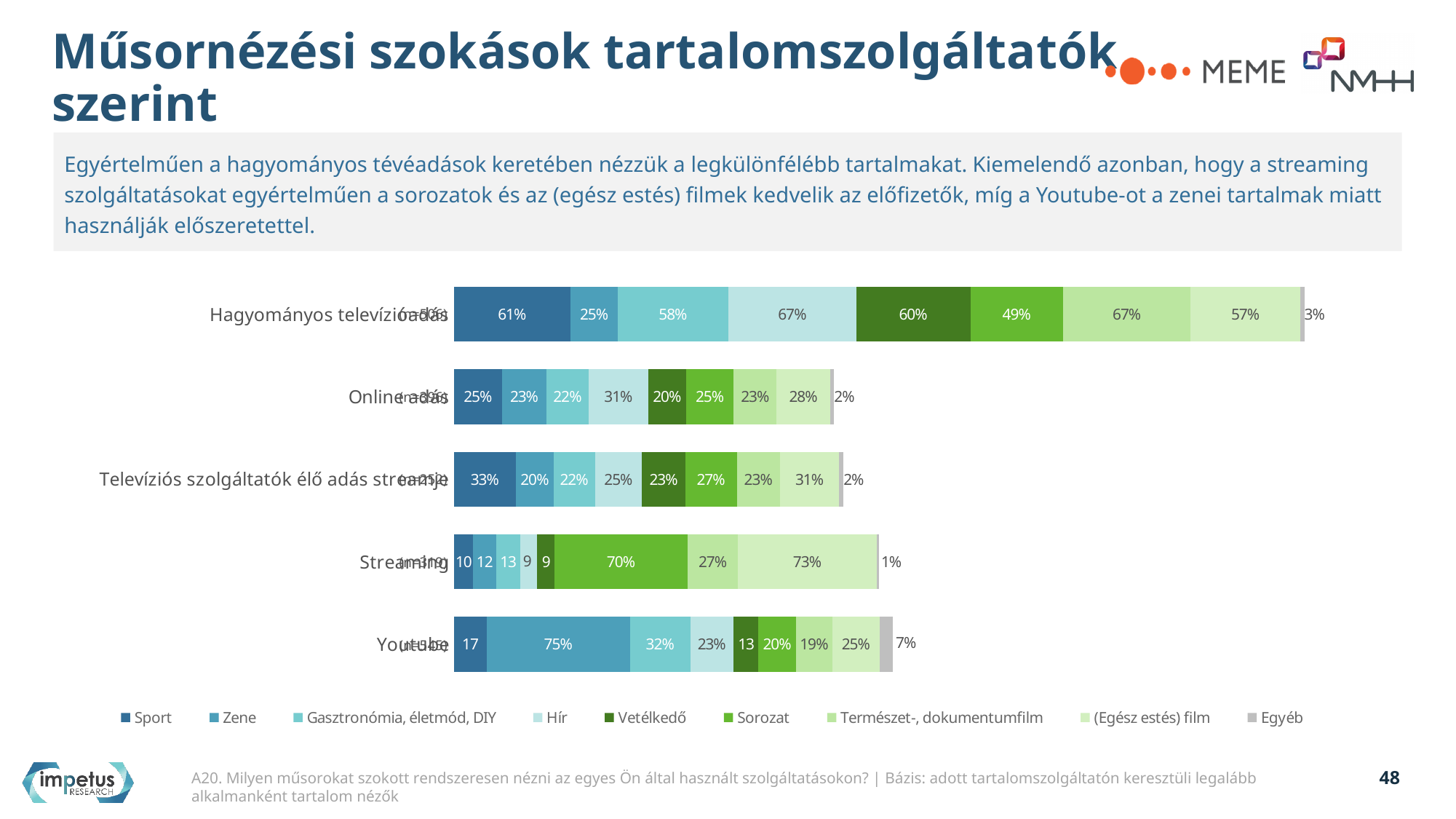
How many categories (content providers) are shown in the chart? 5 What is the value for (Egész estés) film in the Streaming bar? 73% How many series does the legend list? 9 What is the value for Zene in the Youtube bar? 75% What is the value for Sport in the Hagyományos televízióadás bar? 61% Which category has the highest value for Sport? Hagyományos televízióadás Which category has the lowest value for Egyéb? Streaming What is the value for Sorozat in the Streaming bar? 70% What is the difference between the Sorozat value for Streaming and the Sorozat value for Hagyományos televízióadás? 21 percentage points Which is larger: the Hír value for Online adás or the Hír value for Streaming? Online adás What is the value for Egyéb in the Youtube bar? 7% What kind of chart is shown on the slide? Stacked bar chart